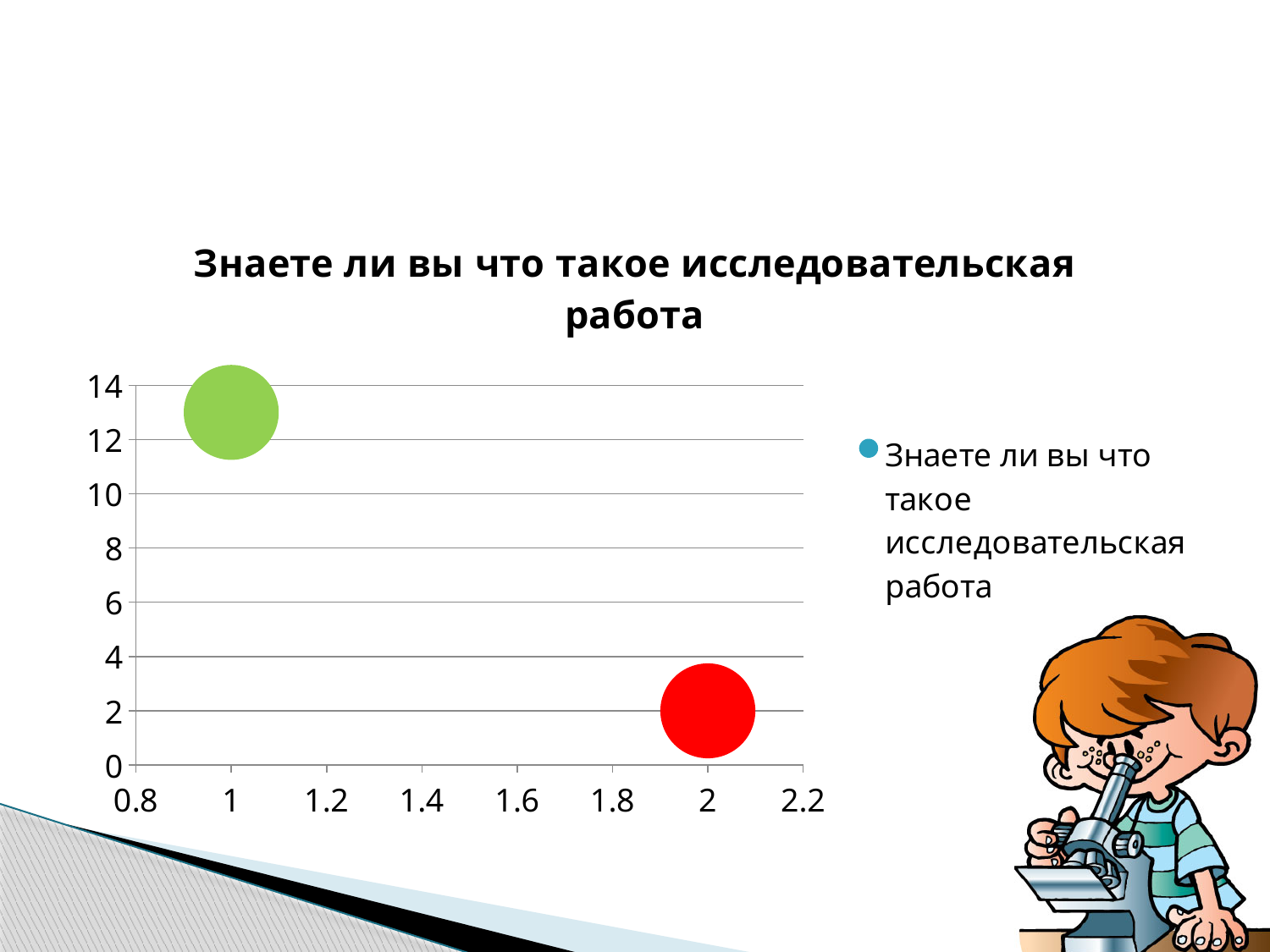
Which bubble has the higher y-axis value, the green one or the red one? The green one What kind of chart is shown on the slide? Bubble chart What is the y-axis value of the red bubble at x = 2? 2 What is the title of the chart? Знаете ли вы что такое исследовательская работа How many bubbles are plotted on the chart? 2 Do the values rise or fall as x increases from 1 to 2? Fall What colour is the bubble plotted at x = 1? Green Is the y-axis value of the green bubble at x = 1 greater or less than 10? greater How many series does the legend list? 1 Is the y-axis value of the green bubble at x = 1 greater or less than 12? greater Which bubble is the lowest on the y axis? The red bubble at x = 2 Is the y-axis value of the red bubble at x = 2 greater or less than 4? less